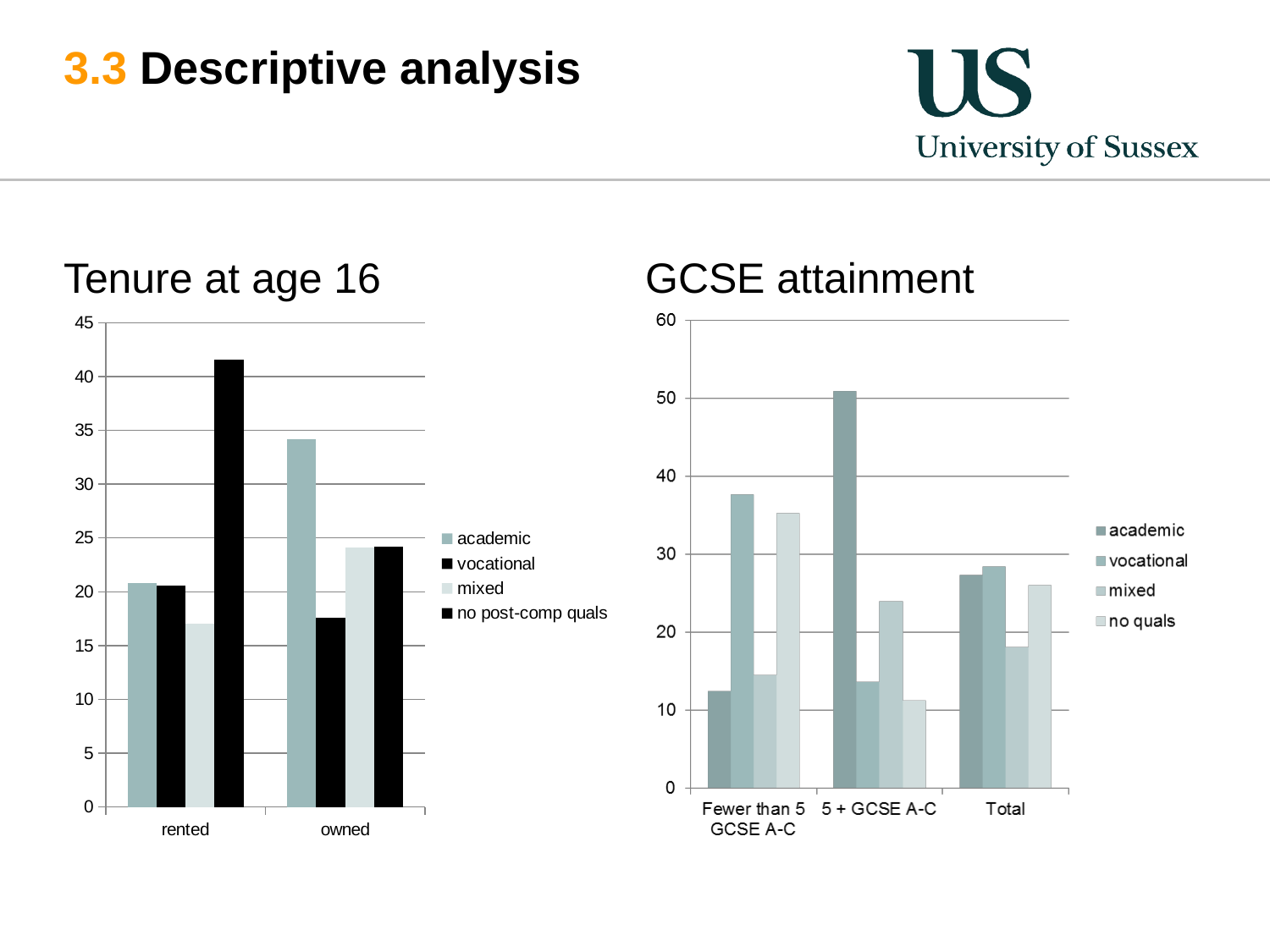
In the GCSE attainment chart, which series has the highest bar for the 5 + GCSE A-C category? academic In the GCSE attainment chart, how many categories are shown on the x axis? 3 In the GCSE attainment chart, which series has the lowest bar for the Fewer than 5 GCSE A-C category? academic What kind of chart is the Tenure at age 16 chart? bar chart In the Tenure at age 16 chart, which series has the highest bar for the rented category? no post-comp quals In the Tenure at age 16 chart, how many series does the legend list? 4 In the Tenure at age 16 chart, is the value for mixed in the rented category greater or less than 20? less In the Tenure at age 16 chart, is the academic bar larger for rented or for owned? owned In the GCSE attainment chart, is the value for mixed in the Total category greater or less than 20? less In the Tenure at age 16 chart, which series has the highest bar for the owned category? academic In the Tenure at age 16 chart, is the value for no post-comp quals in the rented category greater or less than 40? greater